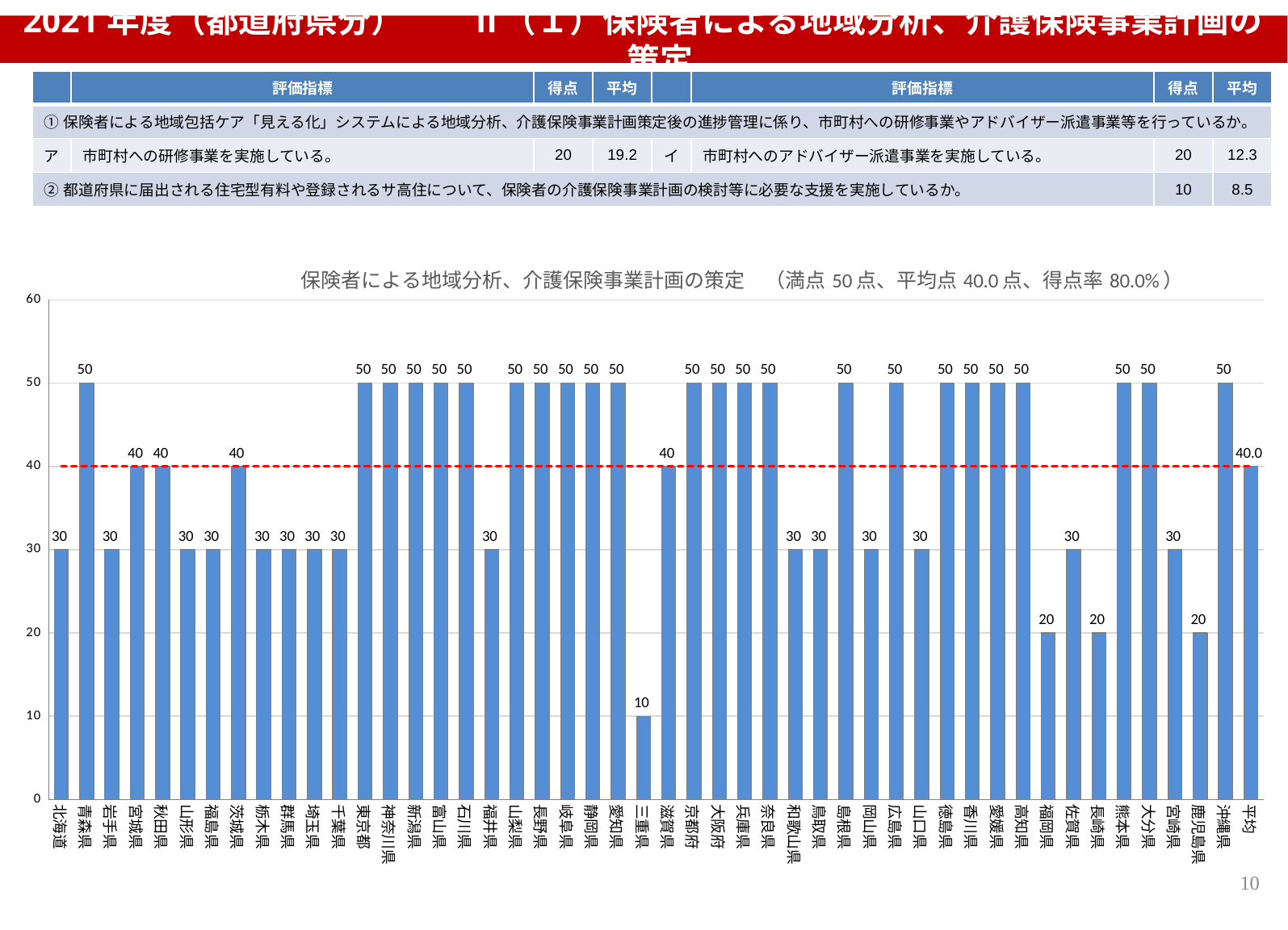
What is the value for 福岡県? 20 Is the value for 三重県 greater or less than 20? less What is the value for 東京都? 50 What kind of chart is shown on the slide? bar chart What is the difference between the values for 青森県 and 岩手県? 20 Which is larger, the value for 滋賀県 or the value for 鹿児島県? 滋賀県 Which category has the lowest value? 三重県 What is the value for 三重県? 10 How many bars are plotted in the chart (including 平均)? 48 What is the value for 北海道? 30 According to the chart title, what is the 得点率? 80.0% What is the value shown for 平均 (the last bar)? 40.0